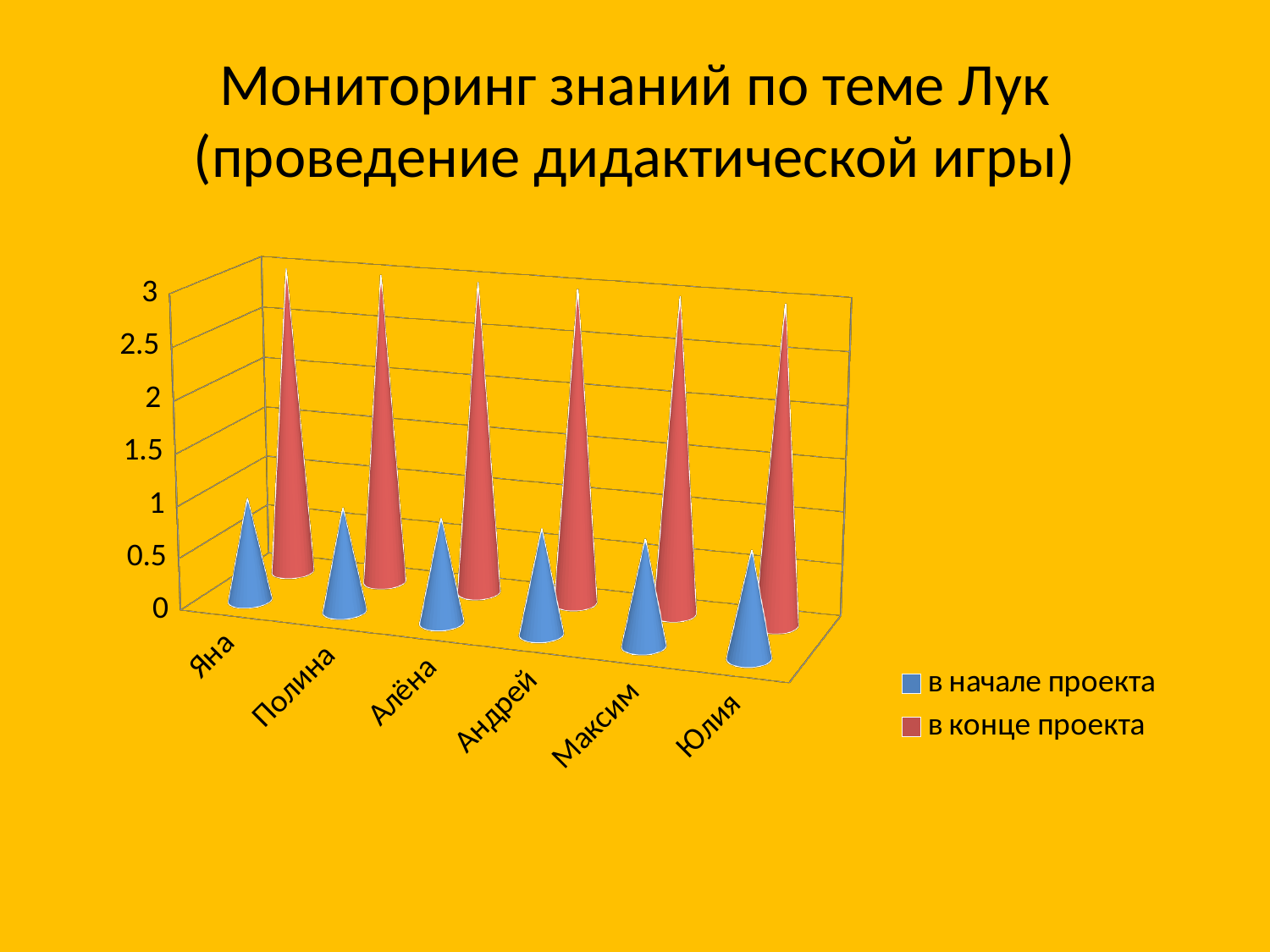
Which colour represents the series 'в конце проекта' in the chart? red How many series does the chart legend list? 2 Which series is larger for Яна: 'в начале проекта' or 'в конце проекта'? в конце проекта What is the highest value shown on the vertical axis of the chart? 3 How many children (categories) are shown on the x axis of the chart? 6 Is the value for Андрей 'в конце проекта' greater or less than 2? greater Is the value for Максим 'в начале проекта' greater or less than 1.5? less Is the value for Алёна 'в конце проекта' greater or less than 1.5? greater What kind of chart is shown on the slide? bar chart Which series is larger for Юлия: 'в начале проекта' or 'в конце проекта'? в конце проекта What is the title of the chart on the slide? Мониторинг знаний по теме Лук (проведение дидактической игры)